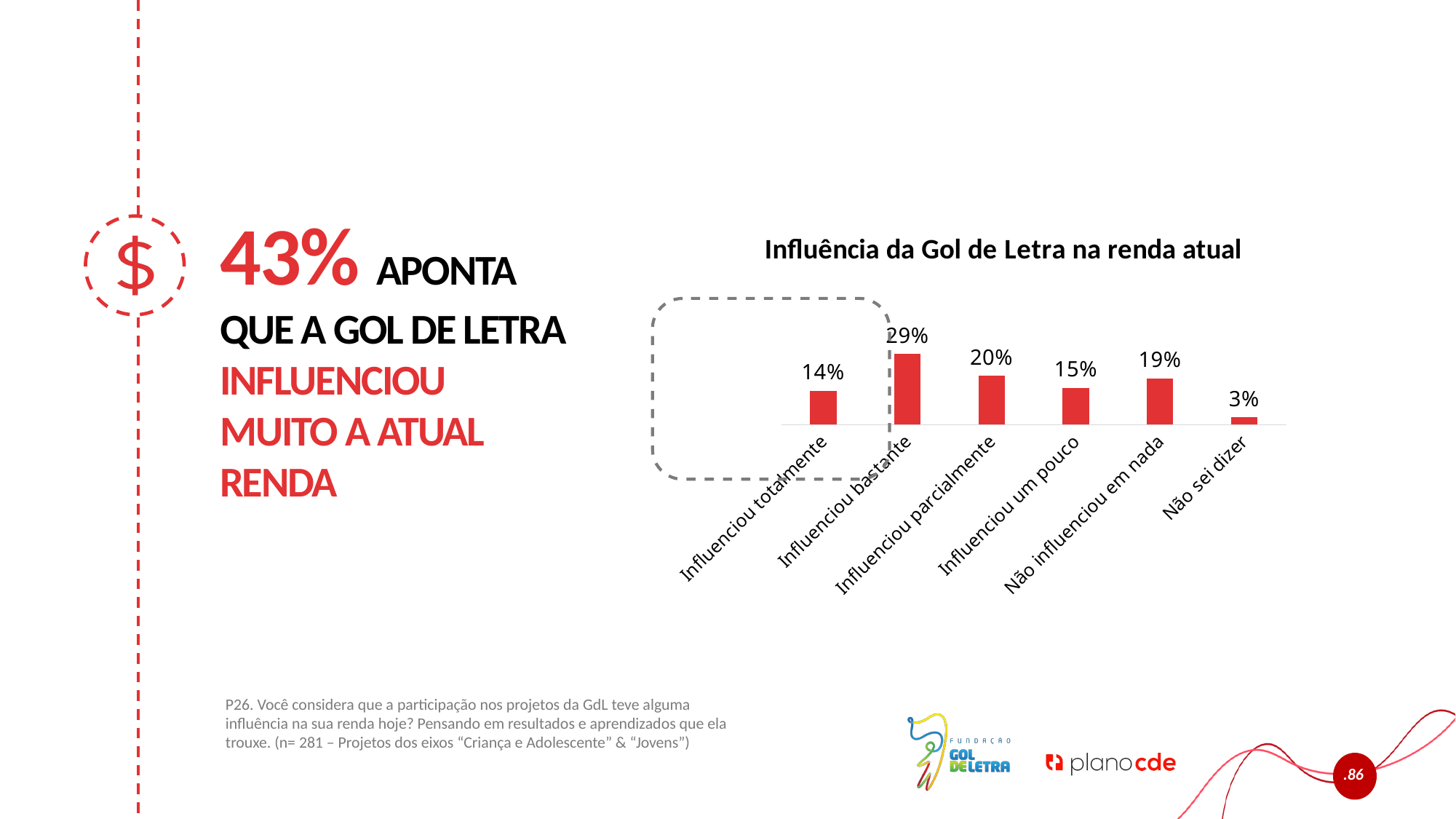
How many categories are shown in the chart? 6 What is the value for "Não influenciou em nada"? 19% What is the value for "Influenciou bastante"? 29% Which category has the highest value? Influenciou bastante Which is larger, "Influenciou um pouco" or "Não influenciou em nada"? Não influenciou em nada What is the value for "Influenciou totalmente"? 14% What is the value for "Não sei dizer"? 3% What is the difference between "Influenciou bastante" and "Influenciou parcialmente"? 9% What is the combined value of "Influenciou totalmente" and "Influenciou bastante"? 43% What is the title of the chart? Influência da Gol de Letra na renda atual Which category has the lowest value? Não sei dizer What kind of chart is shown on the slide? Bar chart